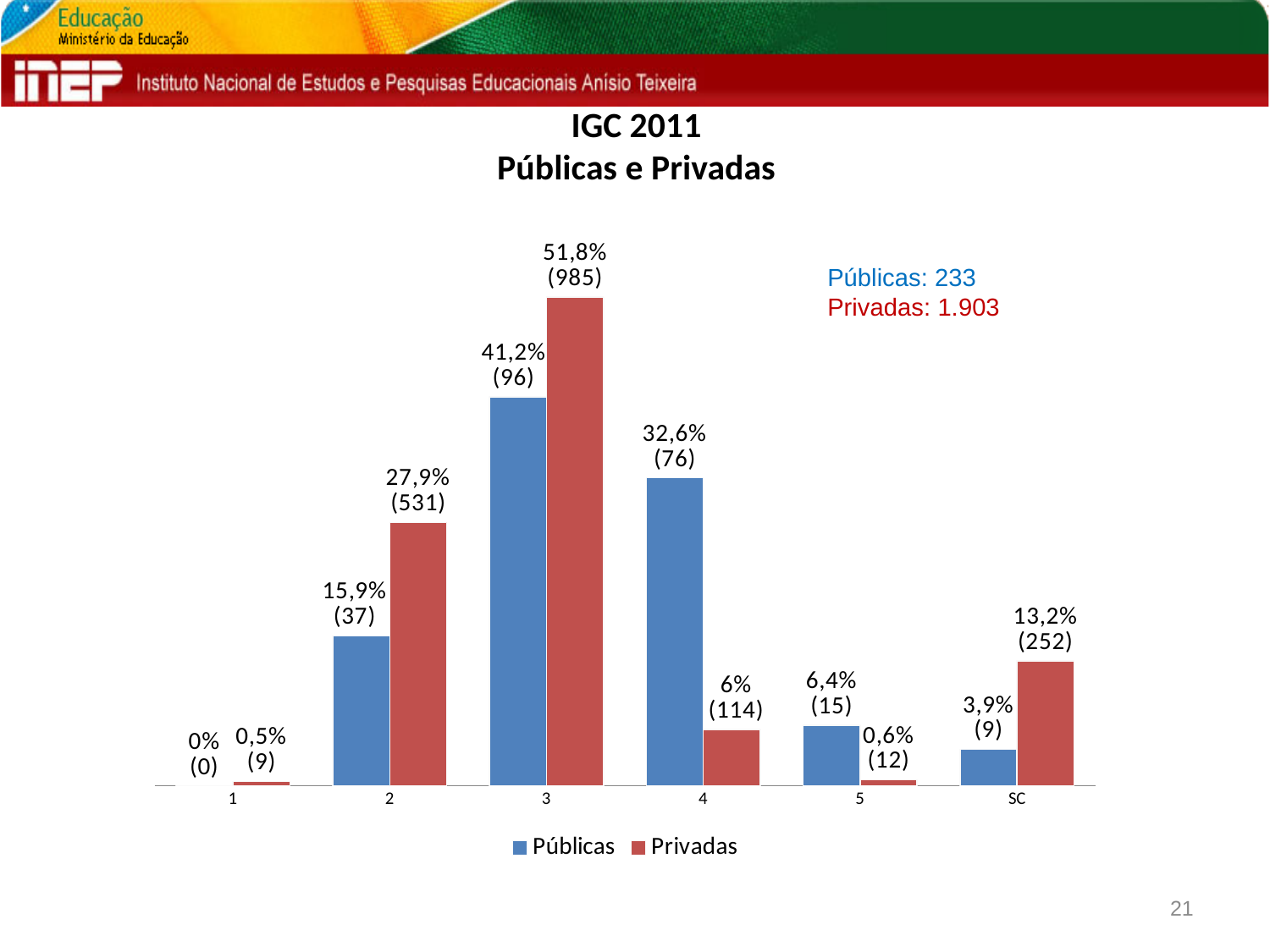
What colour represents the Públicas series? Blue In category 4, which series has the larger value, Públicas or Privadas? Públicas What percentage is shown for Públicas in category SC? 3,9% How many categories are shown on the x axis? 6 What is the total number of Privadas institutions stated on the slide? 1.903 What percentage is shown for Privadas in category 3? 51,8% Which category has the highest value for the Privadas series? 3 What is the count shown in parentheses for Públicas in category 4? 76 What is the difference in percentage points between Privadas and Públicas in category 3? 10,6 What kind of chart is shown on the slide? Bar chart Which category has the lowest value for the Públicas series? 1 How many series does the legend list? 2